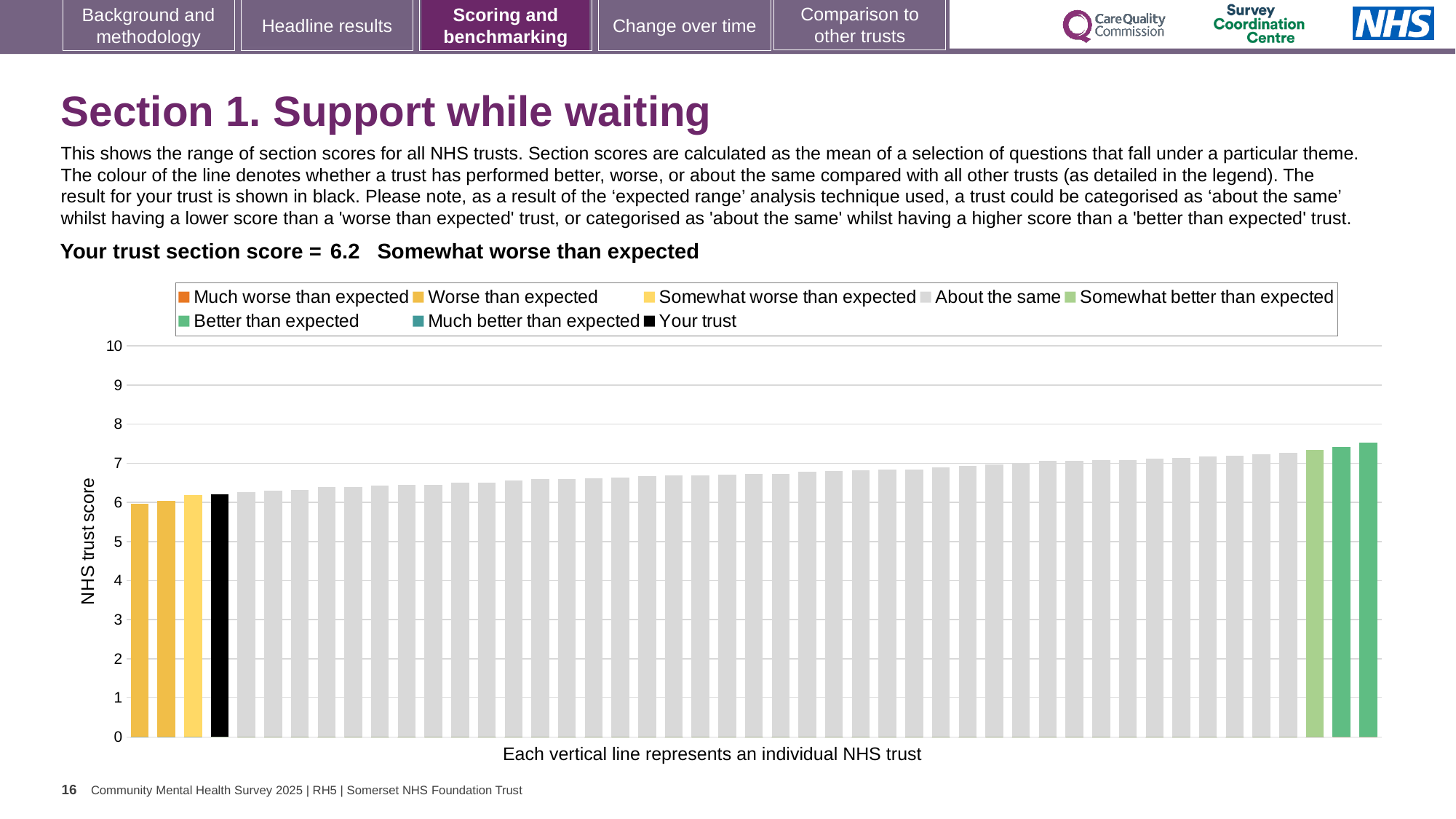
How many entries does the chart legend list? 8 What is the section score for your trust shown on the slide? 6.2 How many bars in the chart are coloured yellow? 3 Is the value of the tallest bar in the chart greater or less than 8? less What is the label on the vertical axis of the chart? NHS trust score Is the value for your trust greater or less than 7? less How is your trust's section score categorised on the slide? Somewhat worse than expected What colour is the bar representing your trust? black How many bars in the chart are coloured green? 3 Do the bar values rise or fall from left to right across the chart? rise Is the value of the tallest bar in the chart greater or less than 7? greater What kind of chart is shown on the slide? bar chart